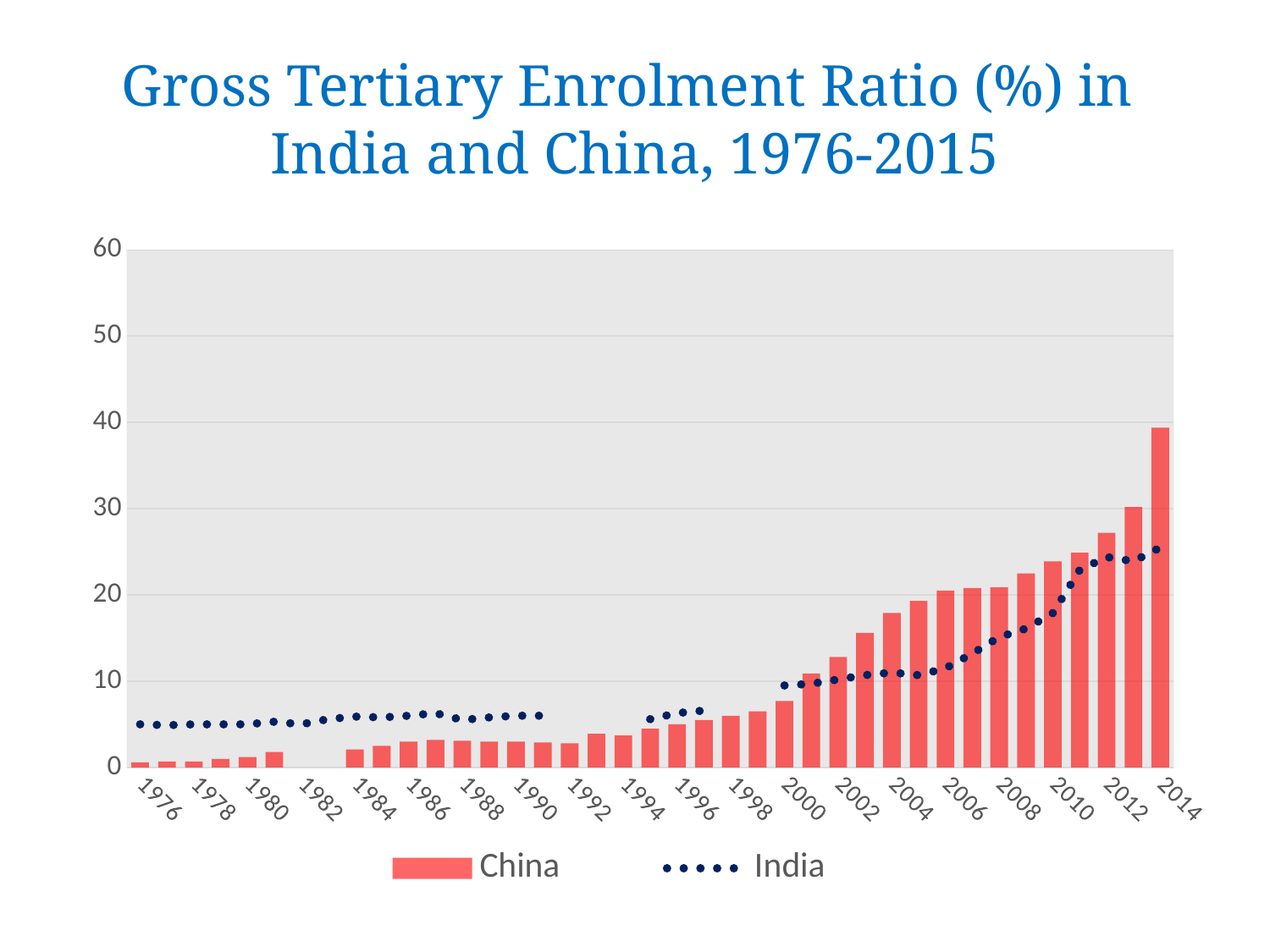
Is the value for India in 1976 greater or less than 10? less Is the value for China in 2014 greater or less than 30? greater How many series does the legend list? 2 Do the China values generally rise or fall from 2000 to 2014? rise Is the value for India in 2014 greater or less than 20? greater What kind of chart is shown on the slide? A combined bar and dotted line chart Which series is shown as red bars? China Which is larger in 2014, the value for China or the value for India? China In which year is the China bar highest? 2014 What is the title of the chart? Gross Tertiary Enrolment Ratio (%) in India and China, 1976-2015 Which is larger in 1990, the value for China or the value for India? India